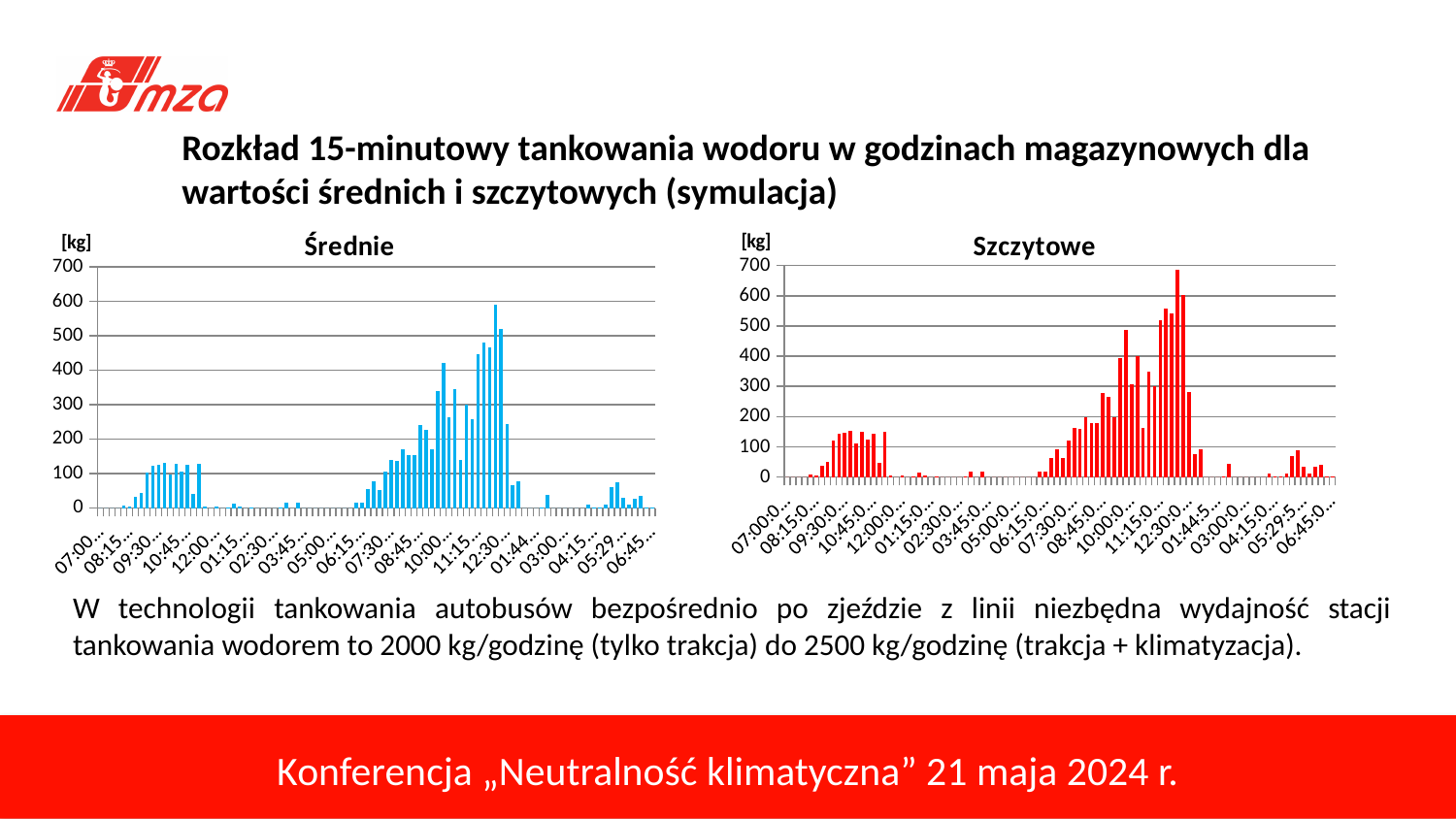
In the "Szczytowe" chart, is the value of the tallest bar greater or less than 600? greater What kind of chart is the "Średnie" chart? bar chart What colour are the bars in the "Szczytowe" chart? red In the "Szczytowe" chart, are the bars around 09:30 greater or less than 200? less What unit is shown on the vertical axis of the "Średnie" chart? [kg] How many charts are shown on the slide? 2 What kind of chart is the "Szczytowe" chart? bar chart Which chart has the higher peak bar, "Średnie" or "Szczytowe"? Szczytowe In the "Średnie" chart, is the value of the tallest bar greater or less than 500? greater What is the highest value shown on the vertical axis of the "Szczytowe" chart? 700